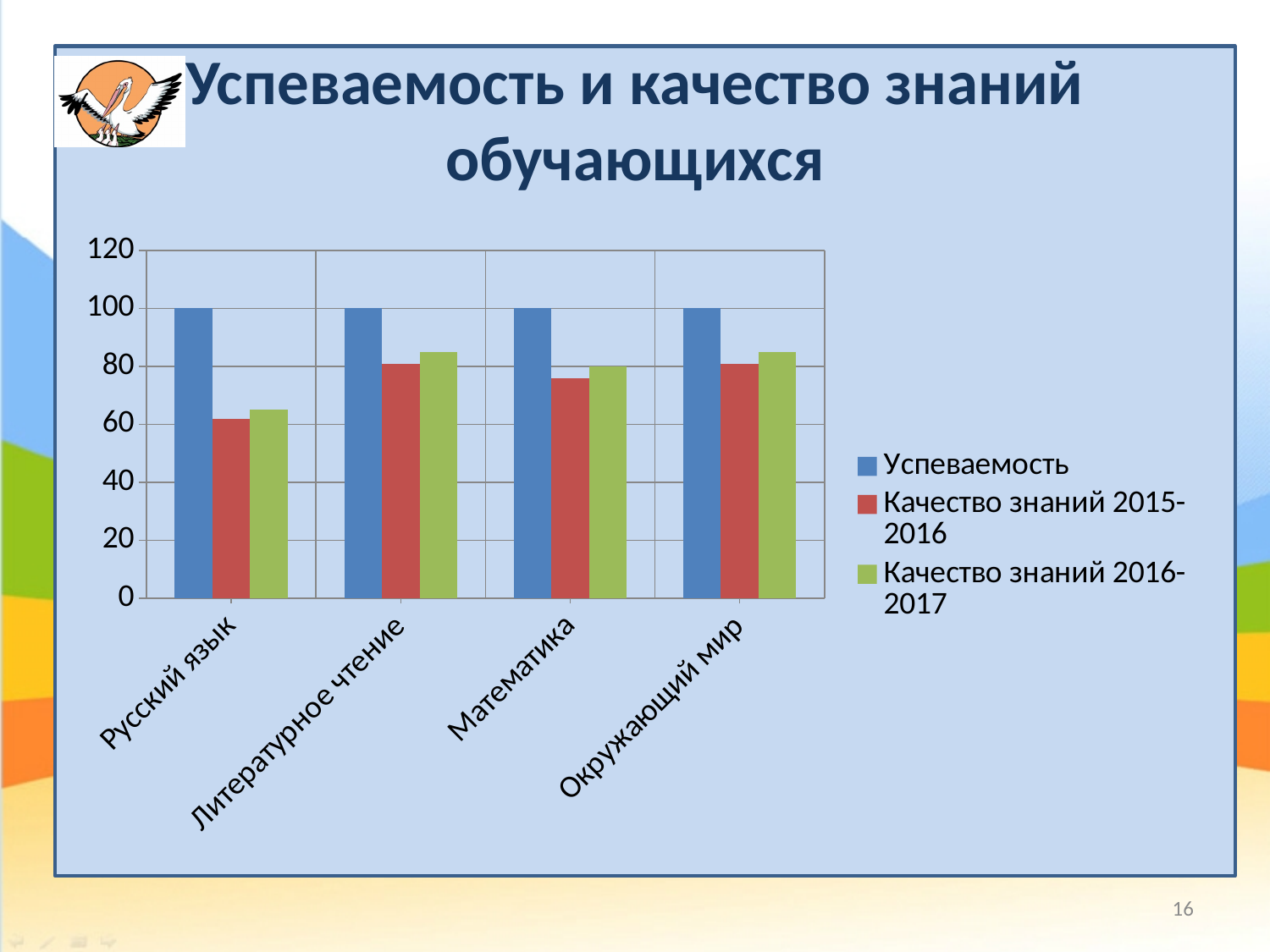
What kind of chart is shown on the slide? bar chart For Русский язык, which is larger: Качество знаний 2015-2016 or Качество знаний 2016-2017? Качество знаний 2016-2017 Is the value of Качество знаний 2015-2016 for Русский язык greater or less than 80? less What is the value of Успеваемость for Математика? 100 Which subject has the lowest value for Качество знаний 2015-2016? Русский язык Is the value of Качество знаний 2016-2017 for Литературное чтение greater or less than 80? greater Is the value of Качество знаний 2016-2017 for Русский язык greater or less than 60? greater What is the title of the slide containing the chart? Успеваемость и качество знаний обучающихся How many subject categories are shown on the x axis of the chart? 4 How many series does the chart legend list? 3 What is the value of Успеваемость for Русский язык? 100